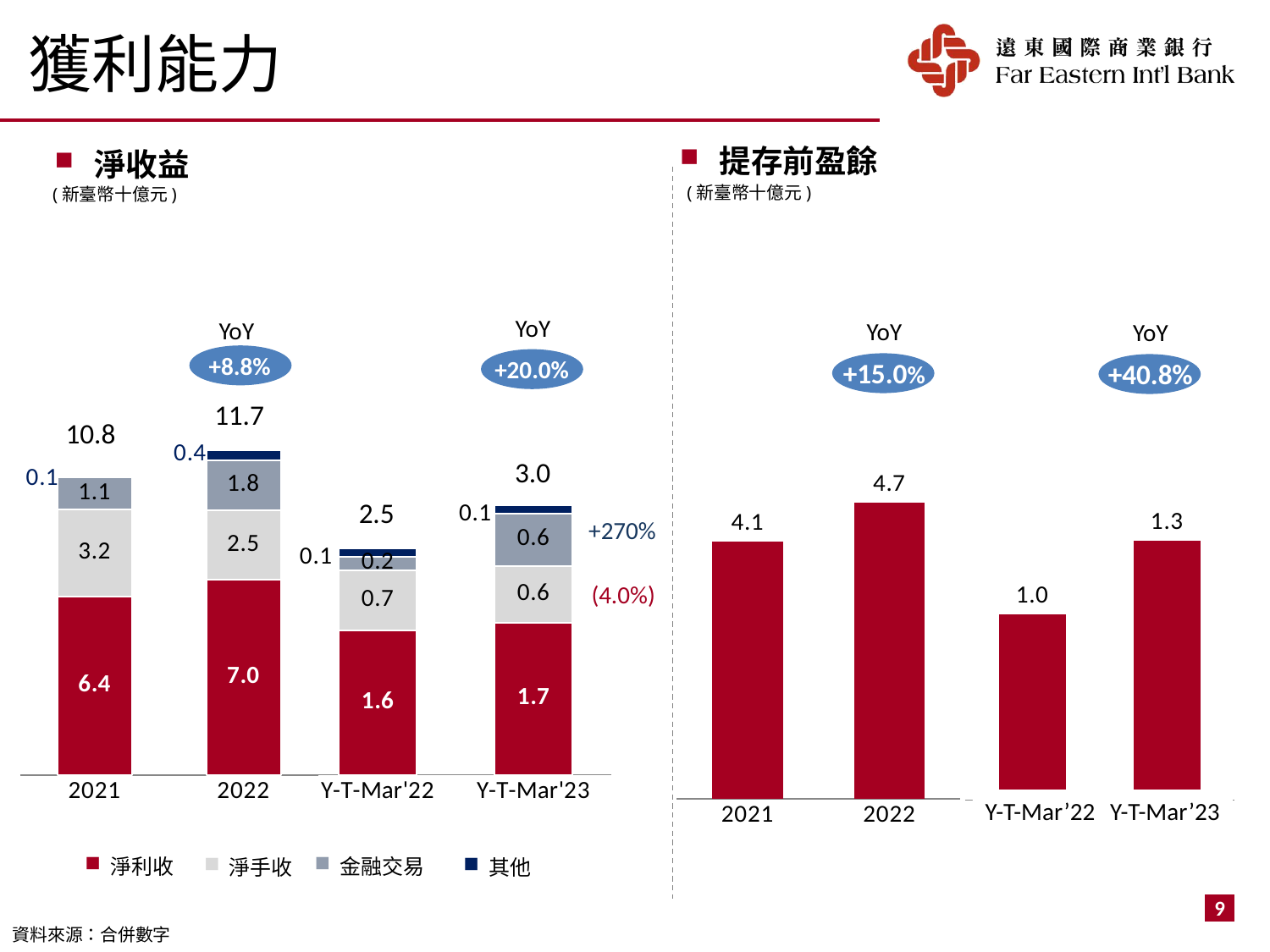
In the 提存前盈餘 chart on the right, what is the difference between Y-T-Mar'23 and Y-T-Mar'22? 0.3 In the 淨收益 chart on the left, what is the 淨利收 value for 2022? 7.0 In the 提存前盈餘 chart on the right, which category has the lowest value? Y-T-Mar'22 In the 淨收益 chart on the left, how many series does the legend list? 4 In the 淨收益 chart on the left, what is the difference between the 2022 total and the 2021 total? 0.9 What kind of chart is the 提存前盈餘 chart on the right? Bar chart In the 提存前盈餘 chart on the right, what is the value for 2022? 4.7 In the 淨收益 chart on the left, what is the 淨手收 value for 2021? 3.2 In the 淨收益 chart on the left, what is the 金融交易 value for Y-T-Mar'22? 0.2 In the 淨收益 chart on the left, what YoY percentage is shown for 2022? +8.8% In the 淨收益 chart on the left, what is the total shown above the Y-T-Mar'23 bar? 3.0 In the 提存前盈餘 chart on the right, how many bars are plotted? 4